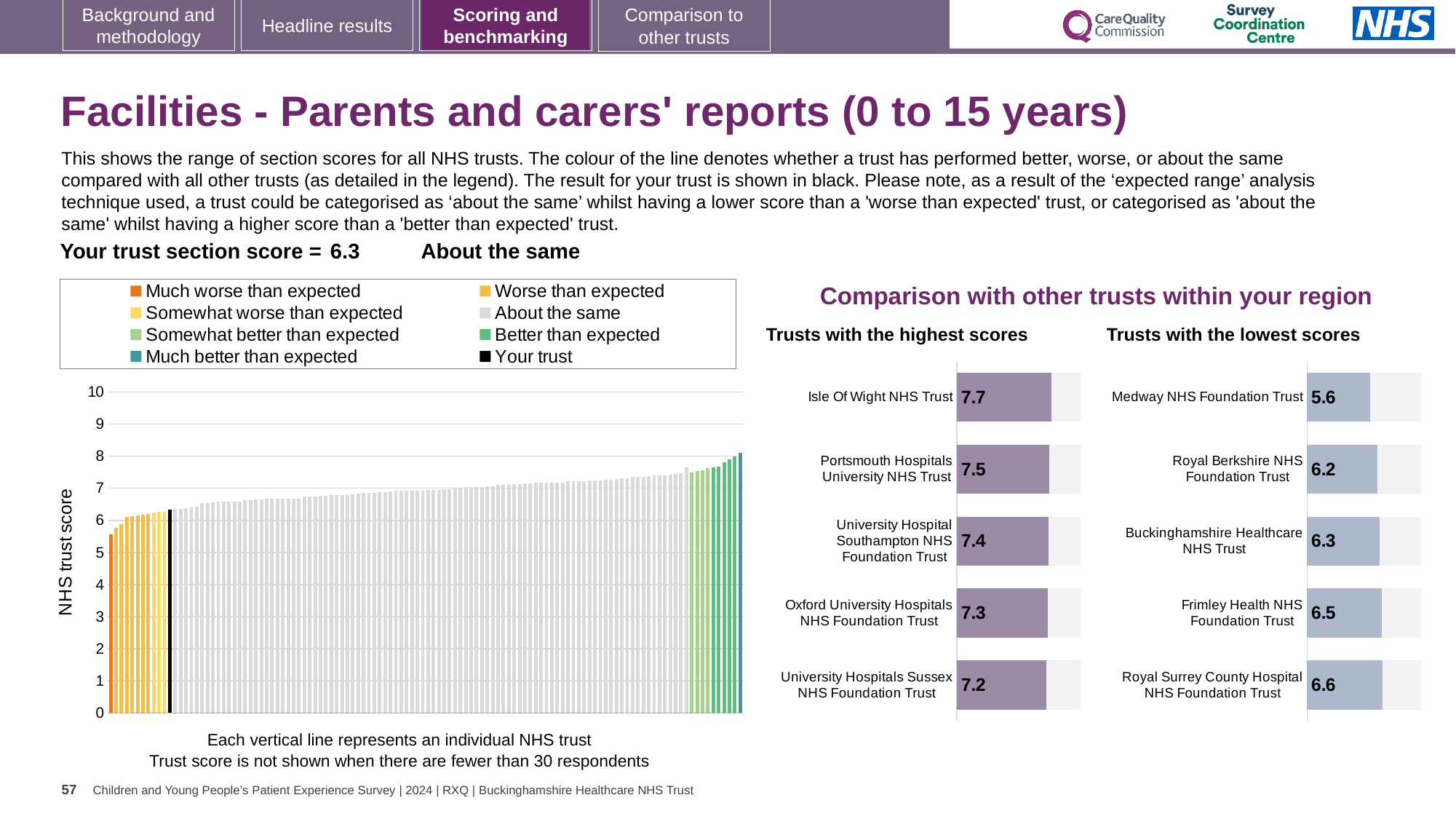
What kind of chart is the 'NHS trust score' chart on the left of the slide? bar chart In the 'Trusts with the lowest scores' chart, what is the difference between the scores of Royal Surrey County Hospital NHS Foundation Trust and Medway NHS Foundation Trust? 1.0 In the 'Trusts with the highest scores' chart, which trust has the highest score? Isle Of Wight NHS Trust In the 'Trusts with the highest scores' chart, what is the difference between the scores of Isle Of Wight NHS Trust and University Hospitals Sussex NHS Foundation Trust? 0.5 How many entries does the legend above the 'NHS trust score' chart list? 8 In the 'Trusts with the lowest scores' chart, which trust has the lowest score? Medway NHS Foundation Trust In the 'Trusts with the lowest scores' chart, what is the score for Medway NHS Foundation Trust? 5.6 In the 'Trusts with the highest scores' chart, which has the higher score: Portsmouth Hospitals University NHS Trust or Oxford University Hospitals NHS Foundation Trust? Portsmouth Hospitals University NHS Trust How many trusts are shown in the 'Trusts with the lowest scores' chart? 5 In the 'NHS trust score' chart on the left, do the bar values rise or fall from left to right? rise In the 'NHS trust score' chart on the left, is the value of the leftmost (orange) bar greater or less than 5? greater In the 'Trusts with the highest scores' chart, what is the score for Isle Of Wight NHS Trust? 7.7